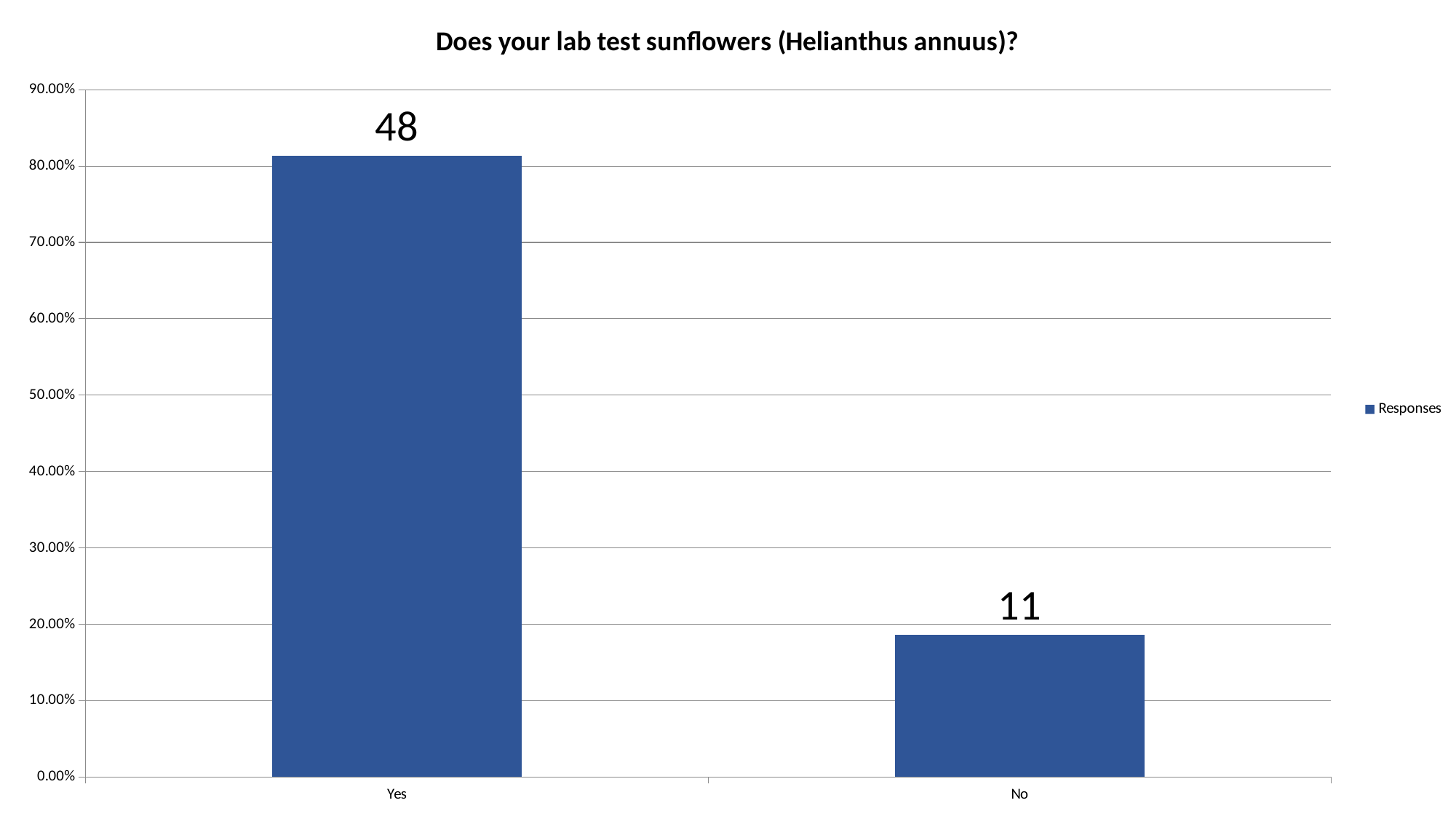
How many series does the legend list? 1 What is the difference between the data labels for Yes and No? 37 Is the percentage for Yes greater or less than 80.00%? greater Which category has the highest bar? Yes How many categories are shown on the x axis? 2 Which category has the lowest bar? No What is the title of the chart? Does your lab test sunflowers (Helianthus annuus)? What is the data label shown on the bar for No? 11 Which is larger, the value for Yes or the value for No? Yes What is the data label shown on the bar for Yes? 48 Is the percentage for No greater or less than 20.00%? less What kind of chart is shown on the slide? bar chart